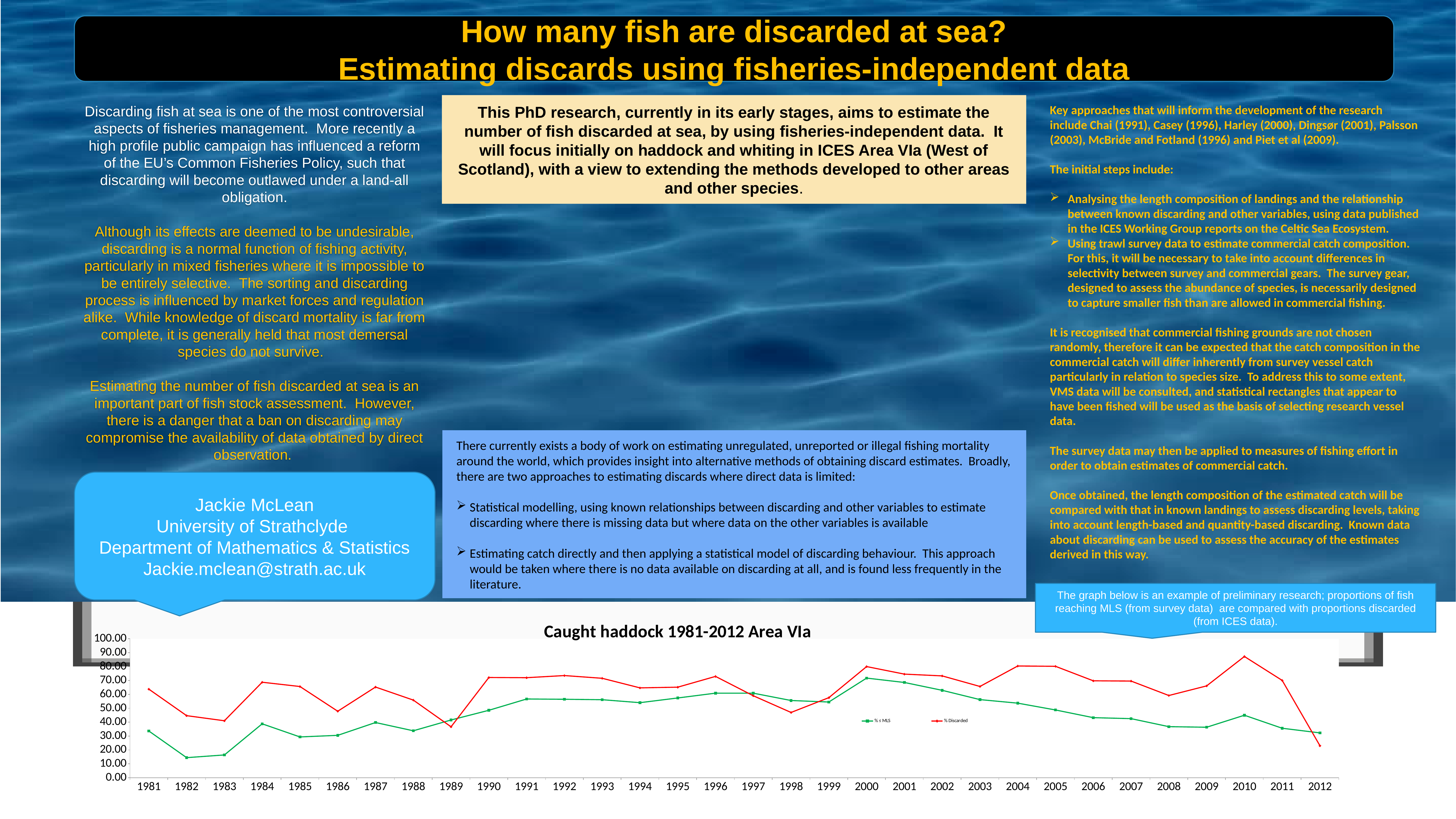
How many series does the chart's legend list? 2 Is the value for % Discarded in 2010 greater or less than 80? greater What is the title of the chart? Caught haddock 1981-2012 Area VIa How many years are plotted along the x axis? 32 In 2012, which series has the larger value, % ≤ MLS or % Discarded? % ≤ MLS Does the % ≤ MLS series rise or fall between 2000 and 2009? fall What are the two series named in the legend? % ≤ MLS and % Discarded In which year is the % Discarded series at its lowest? 2012 What kind of chart is shown on the slide? line chart In which year is the % Discarded series at its highest? 2010 In which year is the % ≤ MLS series at its highest? 2000 Is the value for % ≤ MLS in 1982 greater or less than 20? less